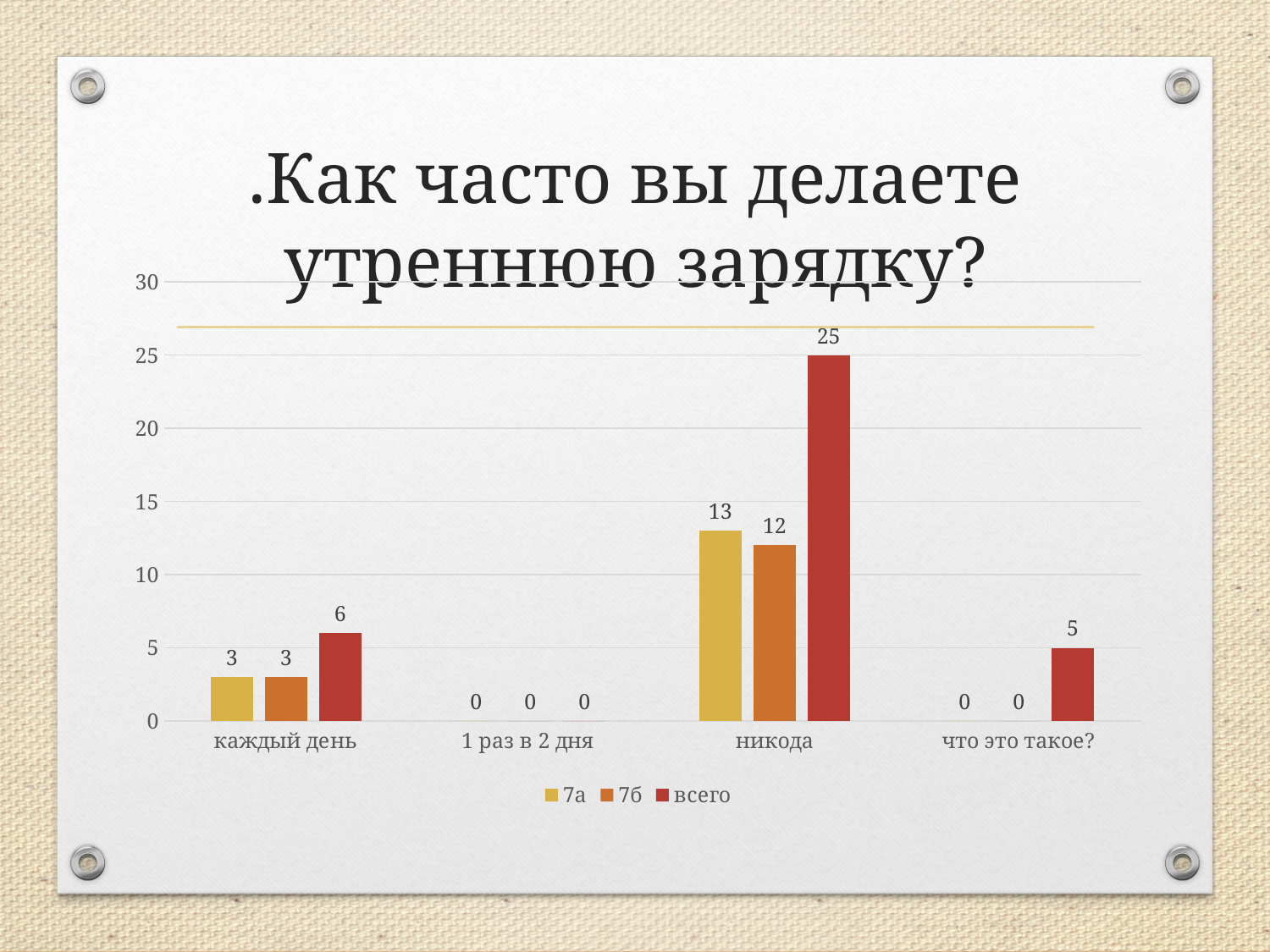
What is the value for 7а in the category "никода"? 13 What is the value for 7б in the category "никода"? 12 What is the difference between the 7а and 7б values in the category "никода"? 1 What are the series names listed in the legend? 7а, 7б, всего Which category has the lowest value for всего? 1 раз в 2 дня Which is larger in the category "никода": the value for 7а or the value for 7б? 7а What is the value for всего in the category "что это такое?"? 5 Which category has the highest value for всего? никода How many series does the legend list? 3 How many categories are shown on the x axis? 4 What kind of chart is shown on the slide? bar chart What is the value for всего in the category "каждый день"? 6